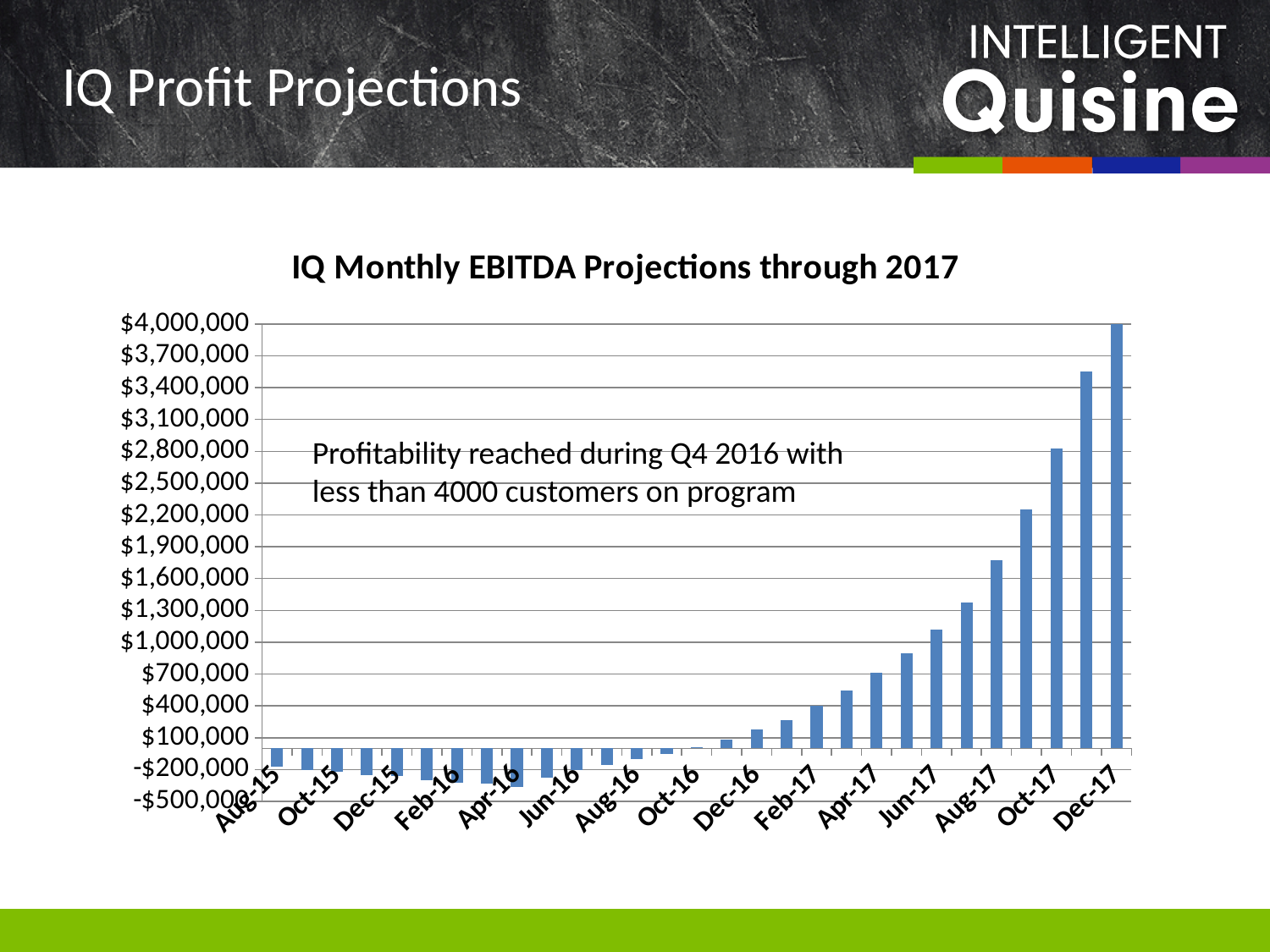
What kind of chart is shown on the slide? Bar chart Is the value for Jun-17 greater or less than $1,000,000? greater Is the value for Dec-17 greater or less than $3,700,000? greater Which month has the highest EBITDA projection? Dec-17 Is the value for Oct-17 greater or less than $2,500,000? greater What does the text annotation inside the chart say? Profitability reached during Q4 2016 with less than 4000 customers on program Which is larger, the value for Oct-17 or the value for Aug-17? Oct-17 What is the title of the chart? IQ Monthly EBITDA Projections through 2017 Do the EBITDA projections generally rise or fall from Aug-15 to Dec-17? Rise